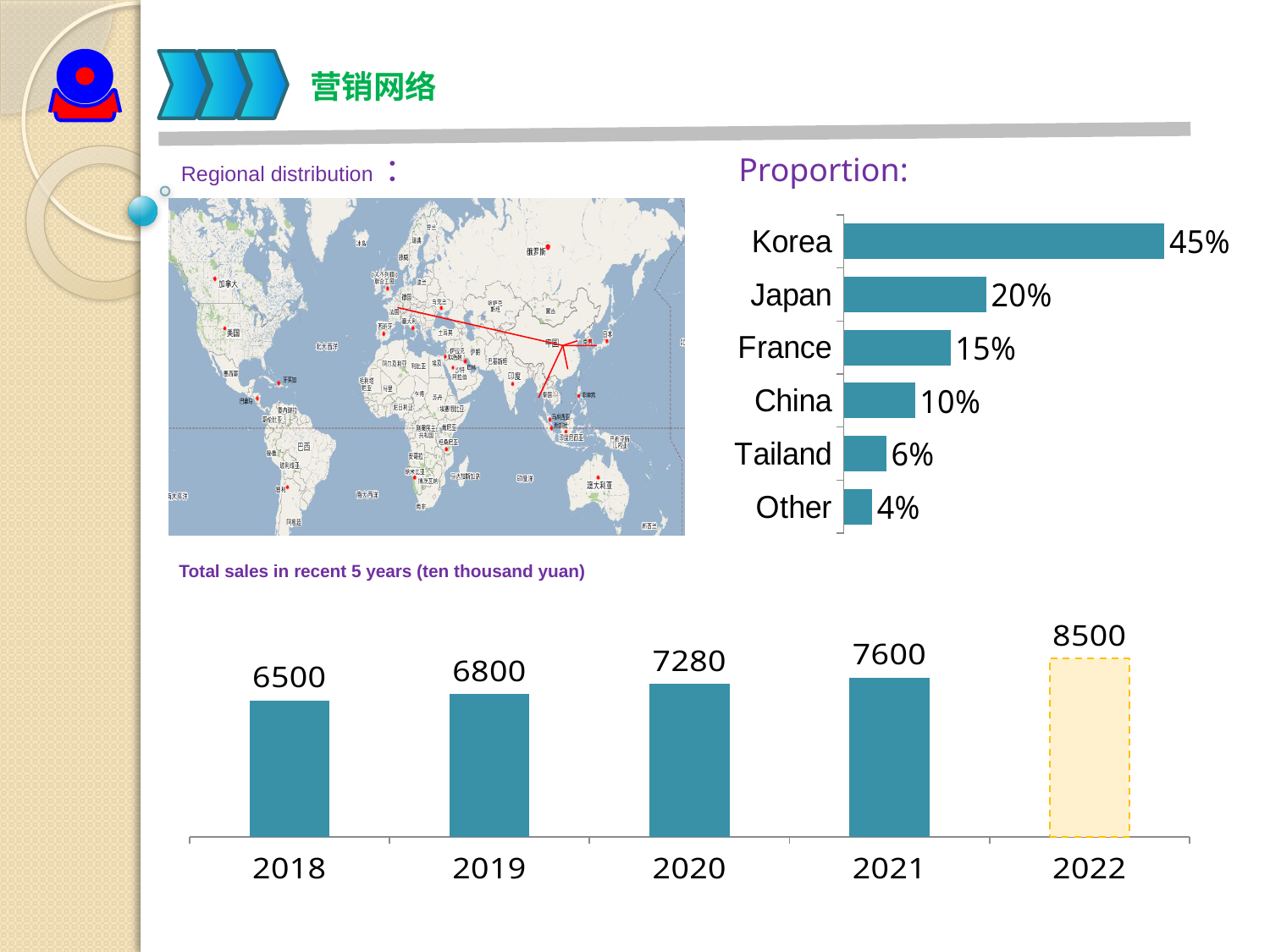
In the Total sales in recent 5 years chart, what is the difference between the values for 2022 and 2021? 900 In the Proportion chart, what is the value for Japan? 20% In the Total sales in recent 5 years chart, how many years are shown? 5 In the Proportion chart, what is the difference between the values for Korea and France? 30% In the Total sales in recent 5 years chart, which is larger, the value for 2019 or the value for 2018? 2019 In the Proportion chart, which category has the highest value? Korea What kind of chart is the Proportion chart? bar chart In the Total sales in recent 5 years chart, which year has the highest value? 2022 In the Proportion chart, which category has the lowest value? Other In the Total sales in recent 5 years chart, what is the value for 2020? 7280 In the Proportion chart, how many categories are shown? 6 In the Total sales in recent 5 years chart, do the values rise or fall from 2018 to 2022? rise